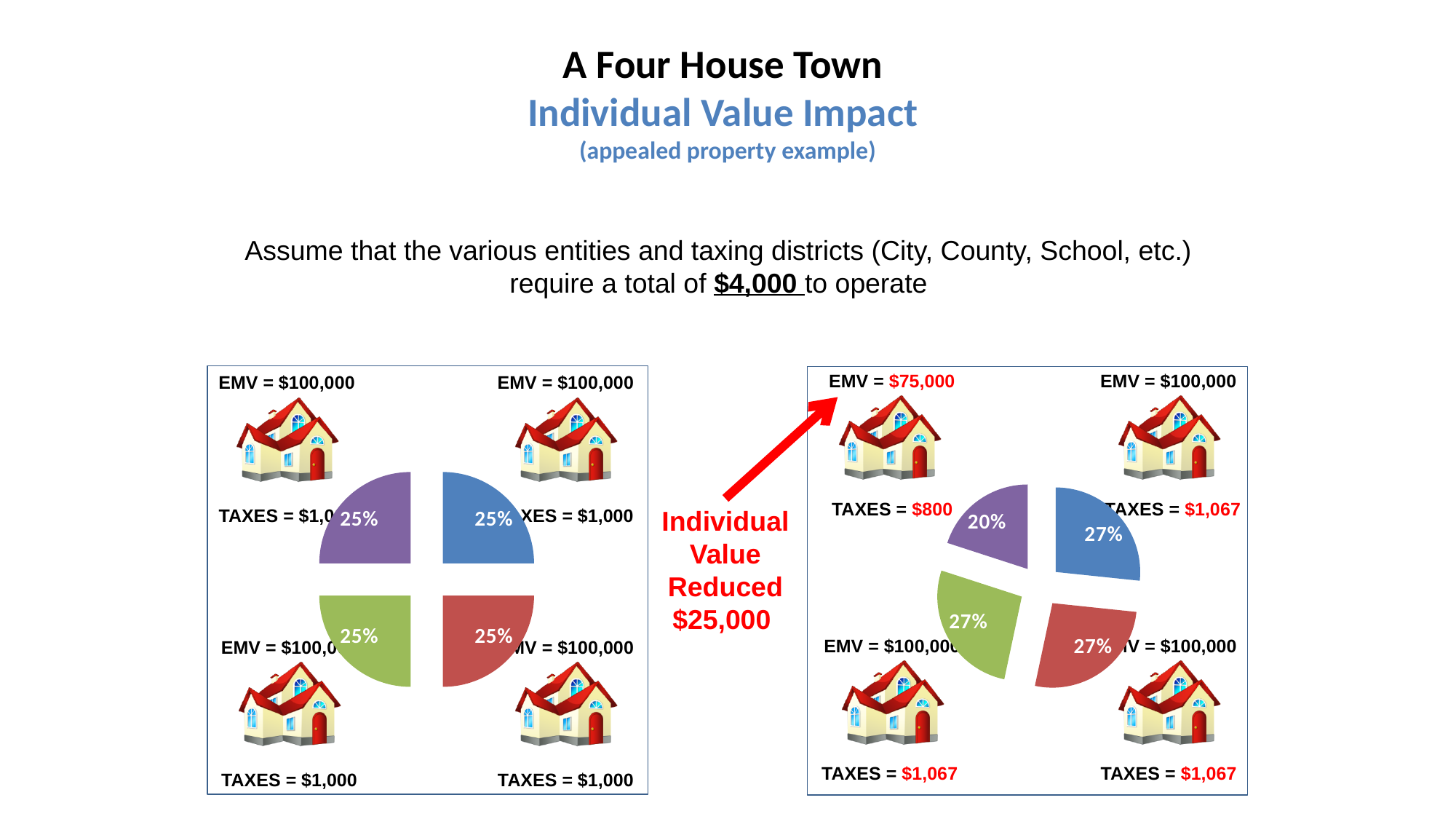
How many slices does the pie chart on the left side of the slide have? 4 In the pie chart on the right side of the slide, which is larger, the purple slice or the green slice? green In the pie chart on the right side of the slide, what is the difference in percentage points between the red slice and the purple slice? 7 In the pie chart on the right side of the slide, what percentage is shown on the purple slice? 20% In the pie chart on the right side of the slide, which colour slice is the smallest? purple How many slices does the pie chart on the right side of the slide have? 4 In the pie chart on the left side of the slide, what percentage is shown on the green slice? 25% In the pie chart on the left side of the slide, what percentage is shown on the purple slice? 25% What kind of chart is shown on the left side of the slide? pie chart In the pie chart on the right side of the slide, what percentage is shown on the blue slice? 27% What kind of chart is shown on the right side of the slide? pie chart In the pie chart on the right side of the slide, what percentage is shown on the red slice? 27%